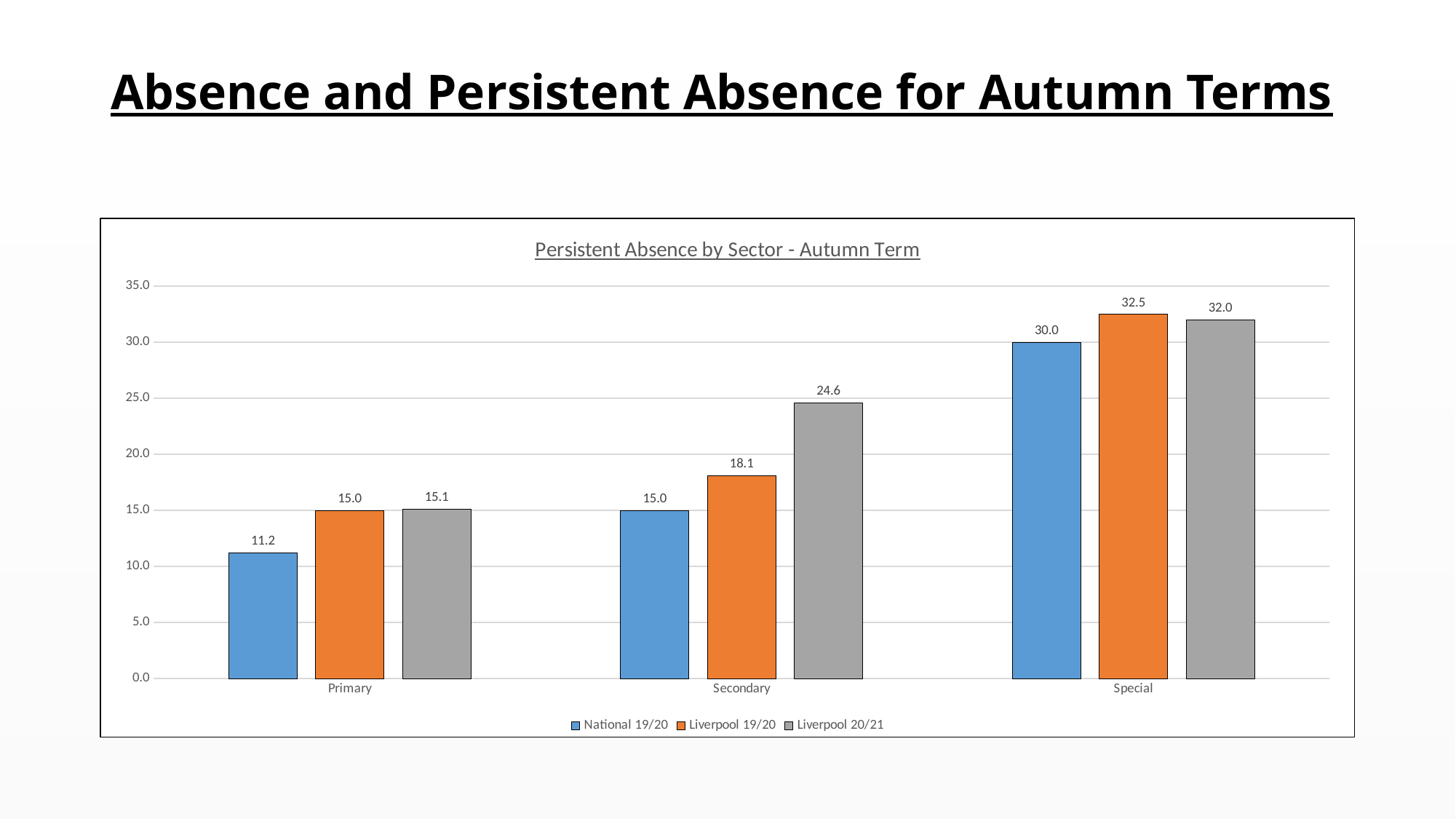
Which sector has the highest value for Liverpool 20/21? Special Which is larger in the Special sector: Liverpool 19/20 or Liverpool 20/21? Liverpool 19/20 What is the difference between Liverpool 20/21 and Liverpool 19/20 in the Secondary sector? 6.5 What is the value for Liverpool 20/21 in the Secondary sector? 24.6 What is the difference between Liverpool 19/20 and National 19/20 in the Primary sector? 3.8 What kind of chart is shown on the slide? Bar chart What is the value for National 19/20 in the Primary sector? 11.2 Which sector has the lowest value for National 19/20? Primary What is the value for Liverpool 19/20 in the Special sector? 32.5 How many series does the legend list? 3 Is the value for Liverpool 20/21 in the Secondary sector greater or less than 20.0? greater How many sectors are shown on the x axis? 3